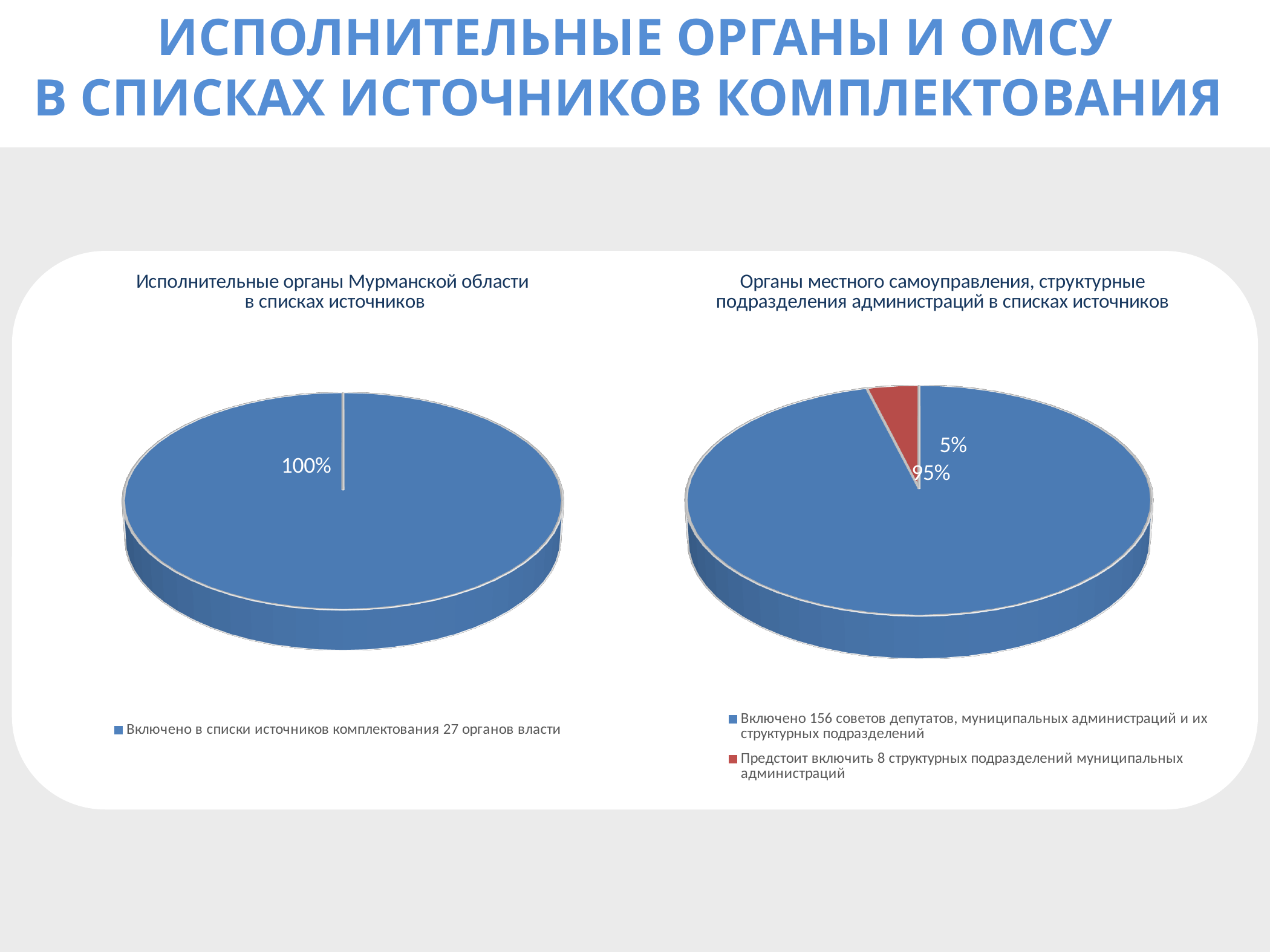
How many slices does the left chart have? 1 In the left chart, what percentage is shown for the slice 'Включено в списки источников комплектования 27 органов власти'? 100% How many entries does the legend of the right chart list? 2 In the right chart, what is the difference in percentage points between the 95% slice and the 5% slice? 90 In the right chart, what share is shown for 'Предстоит включить 8 структурных подразделений муниципальных администраций'? 5% What type of chart is the right chart, 'Органы местного самоуправления, структурные подразделения администраций в списках источников'? Pie chart In the right chart, which slice is the largest? Включено 156 советов депутатов, муниципальных администраций и их структурных подразделений How many slices does the right chart have? 2 In the right chart, which slice is the smallest? Предстоит включить 8 структурных подразделений муниципальных администраций In the right chart, what share is shown for 'Включено 156 советов депутатов, муниципальных администраций и их структурных подразделений'? 95% In the right chart, what colour is the slice for 'Предстоит включить 8 структурных подразделений муниципальных администраций'? Red What type of chart is the left chart, 'Исполнительные органы Мурманской области в списках источников'? Pie chart